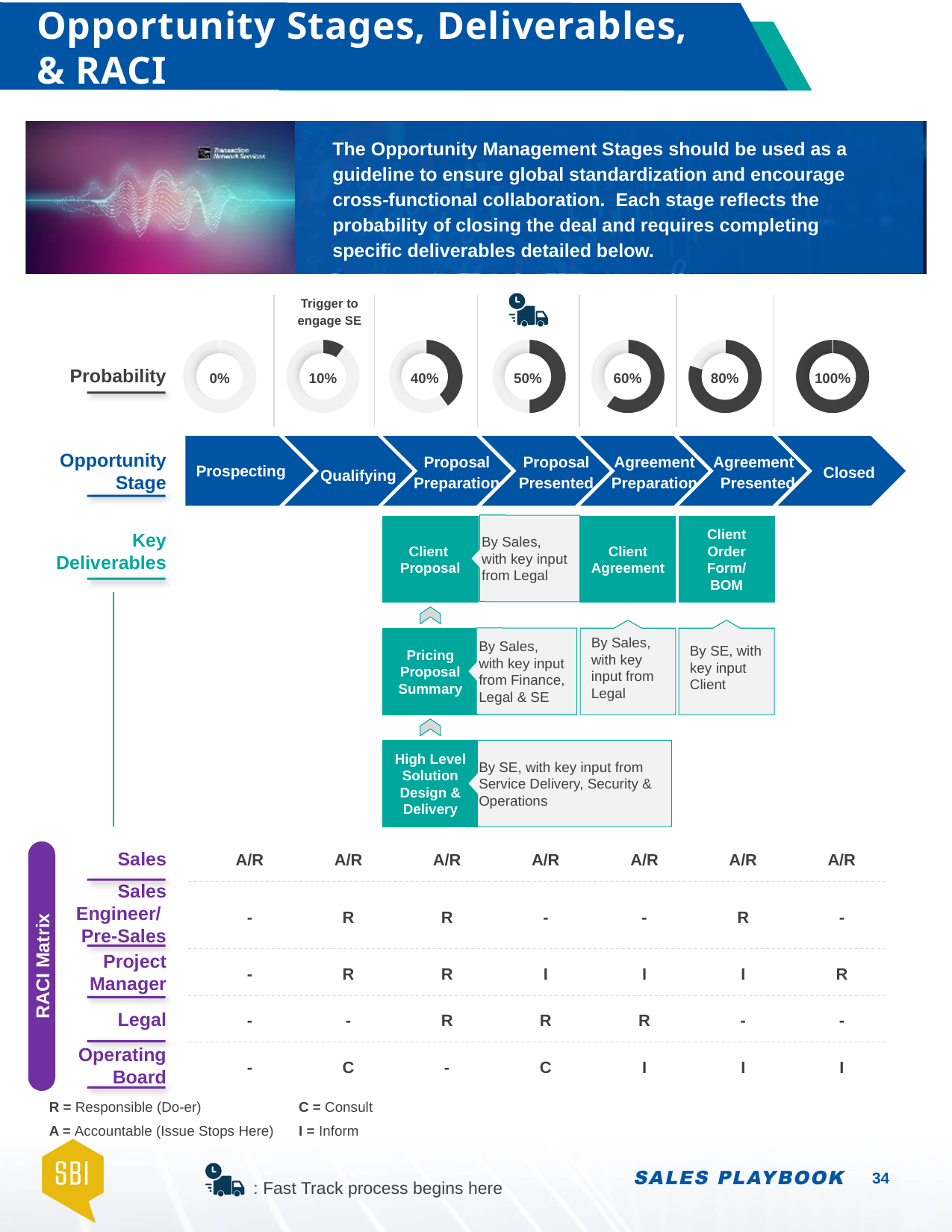
Do the probability values rise or fall as the opportunity stages progress from Prospecting to Closed? Rise In the Probability row of donut charts, what probability is shown for the Proposal Presented stage? 50% What kind of chart is used to show the probability for each opportunity stage? Donut chart In the Probability row of donut charts, what probability is shown for the Proposal Preparation stage? 40% In the Probability row of donut charts, which opportunity stage has the lowest probability? Prospecting How many donut charts are shown in the Probability row? 7 In the Probability row of donut charts, which opportunity stage has the highest probability? Closed In the Probability row of donut charts, what is the difference in probability between the Agreement Presented stage and the Agreement Preparation stage? 20% In the Probability row of donut charts, what is the difference in probability between the Proposal Presented stage and the Qualifying stage? 40% In the Probability row of donut charts, which has a higher probability: Proposal Preparation or Agreement Preparation? Agreement Preparation In the Probability row of donut charts, what probability is shown for the Agreement Presented stage? 80% In the Probability row of donut charts, what probability is shown for the Qualifying stage? 10%